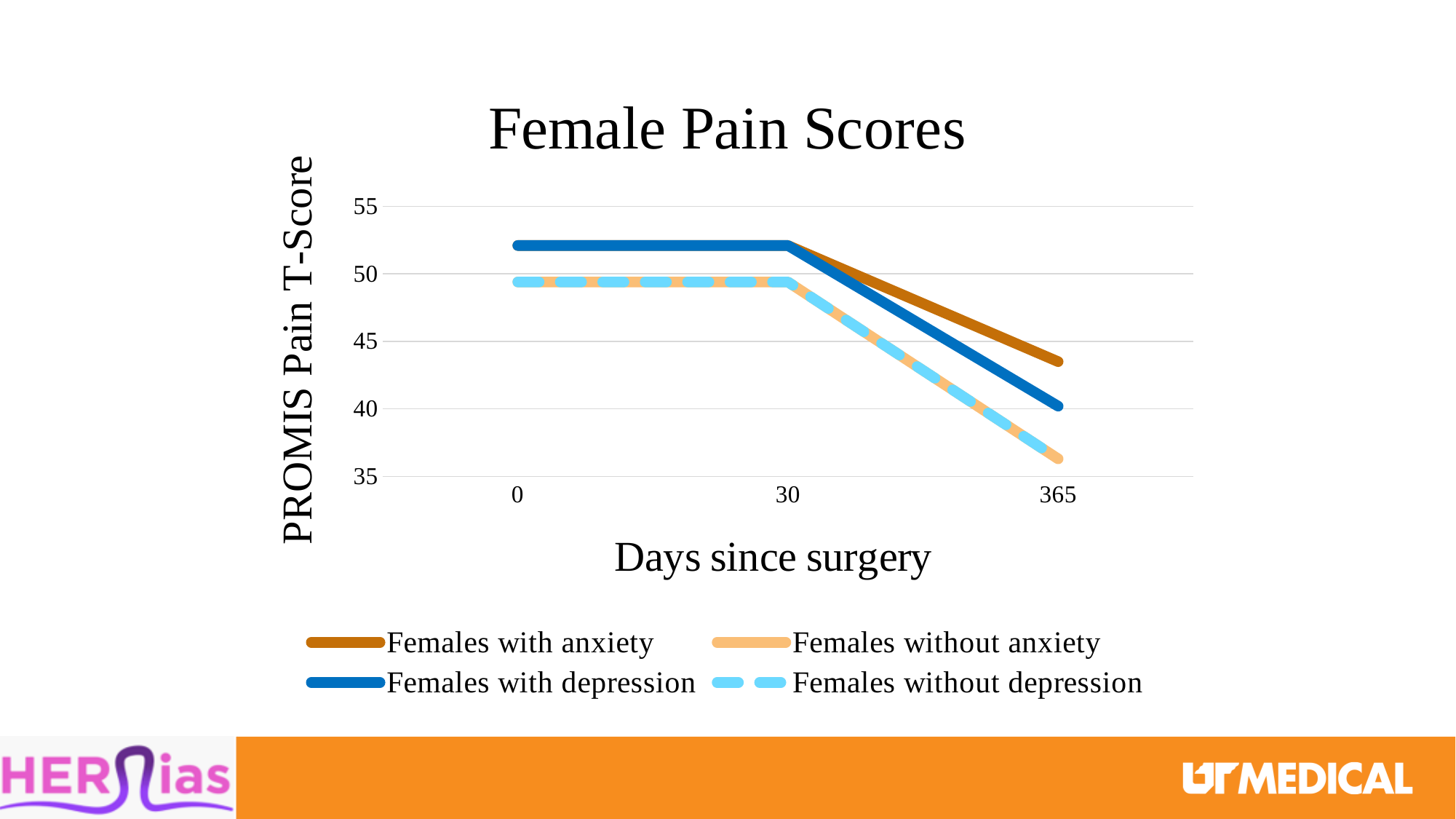
What kind of chart is shown on the slide? line chart How many points on the x axis (days since surgery) are plotted? 3 Is the value for Females with depression at day 365 greater or less than 45? less What is the title of the chart? Female Pain Scores Is the value for Females with anxiety at day 0 greater or less than 50? greater What is the label of the y axis? PROMIS Pain T-Score Do the pain scores for Females with depression rise or fall between day 30 and day 365? fall Which series has the highest value at day 365? Females with anxiety Is the value for Females without depression at day 365 greater or less than 40? less How many series does the legend list? 4 At day 365, which is larger: the value for Females with depression or the value for Females without depression? Females with depression